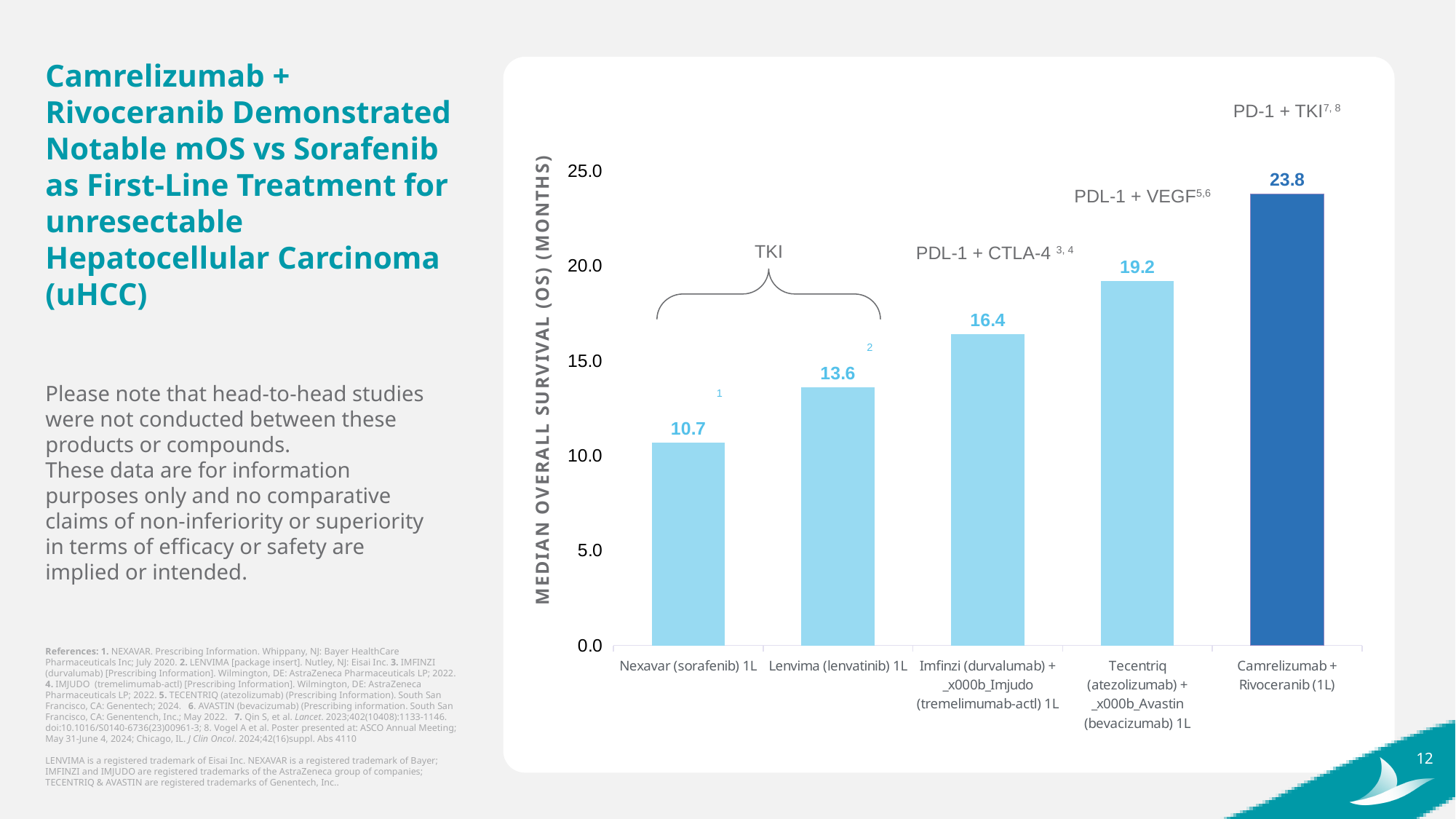
What is the median overall survival shown for Tecentriq (atezolizumab) + Avastin (bevacizumab) 1L? 19.2 Which treatment has the lowest median overall survival on the chart? Nexavar (sorafenib) 1L What is the median overall survival shown for Lenvima (lenvatinib) 1L? 13.6 What is the difference in median overall survival between Camrelizumab + Rivoceranib (1L) and Nexavar (sorafenib) 1L? 13.1 What kind of chart is shown on the slide? bar chart How many treatment categories are plotted on the chart? 5 Which treatment has the highest median overall survival on the chart? Camrelizumab + Rivoceranib (1L) Which has a higher median overall survival, Imfinzi (durvalumab) + Imjudo (tremelimumab-actl) 1L or Lenvima (lenvatinib) 1L? Imfinzi (durvalumab) + Imjudo (tremelimumab-actl) 1L Is the value for Tecentriq (atezolizumab) + Avastin (bevacizumab) 1L greater or less than 20.0? less What is the median overall survival shown for Nexavar (sorafenib) 1L? 10.7 What is the median overall survival shown for Camrelizumab + Rivoceranib (1L)? 23.8 What is the label of the vertical axis of the chart? MEDIAN OVERALL SURVIVAL (OS) (MONTHS)